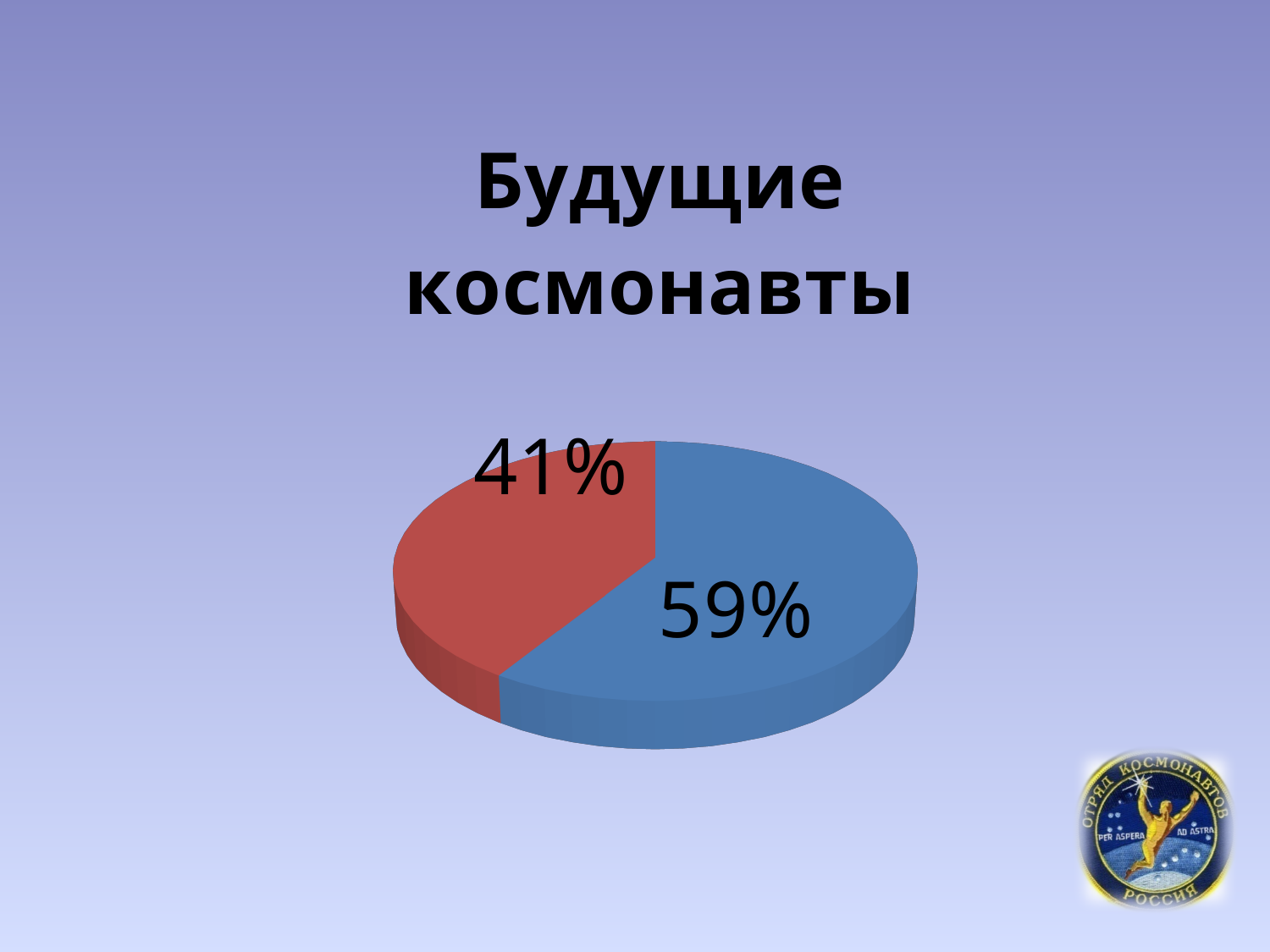
Which slice of the pie chart is the smallest? the red slice (41%) What is the title of the chart on the slide? Будущие космонавты What is the difference in percentage points between the blue slice and the red slice? 18 percentage points What share of the pie does the blue slice represent? 59% Is the value of the blue slice greater or less than 50%? greater Which is larger, the blue slice or the red slice? the blue slice What colours are the two slices of the pie chart? blue and red Is the value of the red slice greater or less than 50%? less How many slices does the pie chart have? 2 Which slice of the pie chart is the largest? the blue slice (59%) What kind of chart is shown on the slide? pie chart What share of the pie does the red slice represent? 41%